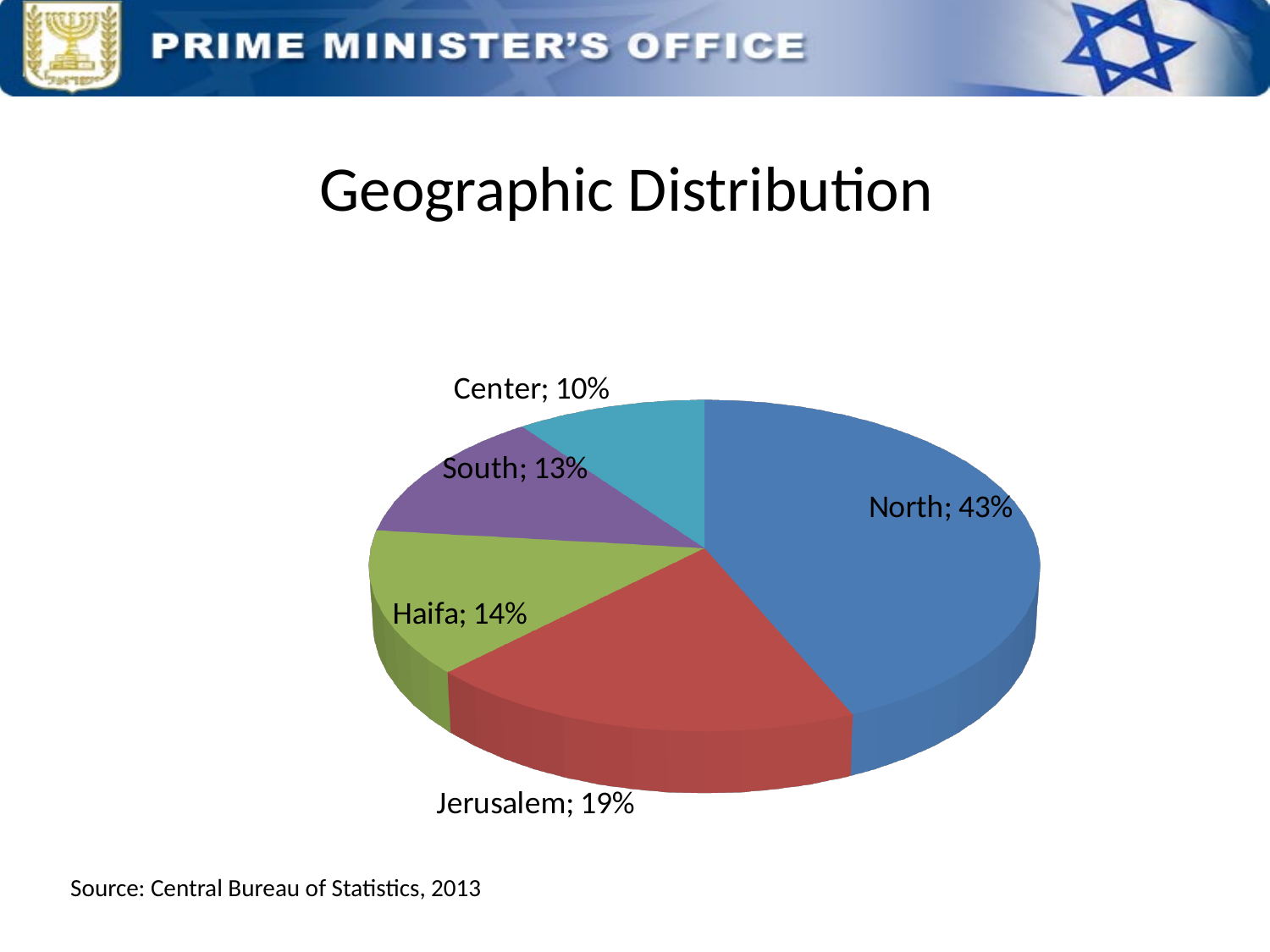
What is the title of the chart? Geographic Distribution What percentage is shown for Haifa? 14% What is the value shown for Jerusalem? 19% Which is larger, the share for Jerusalem or the share for Haifa? Jerusalem What share of the pie does North represent? 43% Which region has the largest slice of the pie? North What is the difference between the North and Jerusalem shares? 24% What kind of chart is shown on the slide? Pie chart What is the difference between the Haifa and South shares? 1% Which region has the smallest slice of the pie? Center How many regions are shown in the pie chart? 5 What is the value for Center? 10%